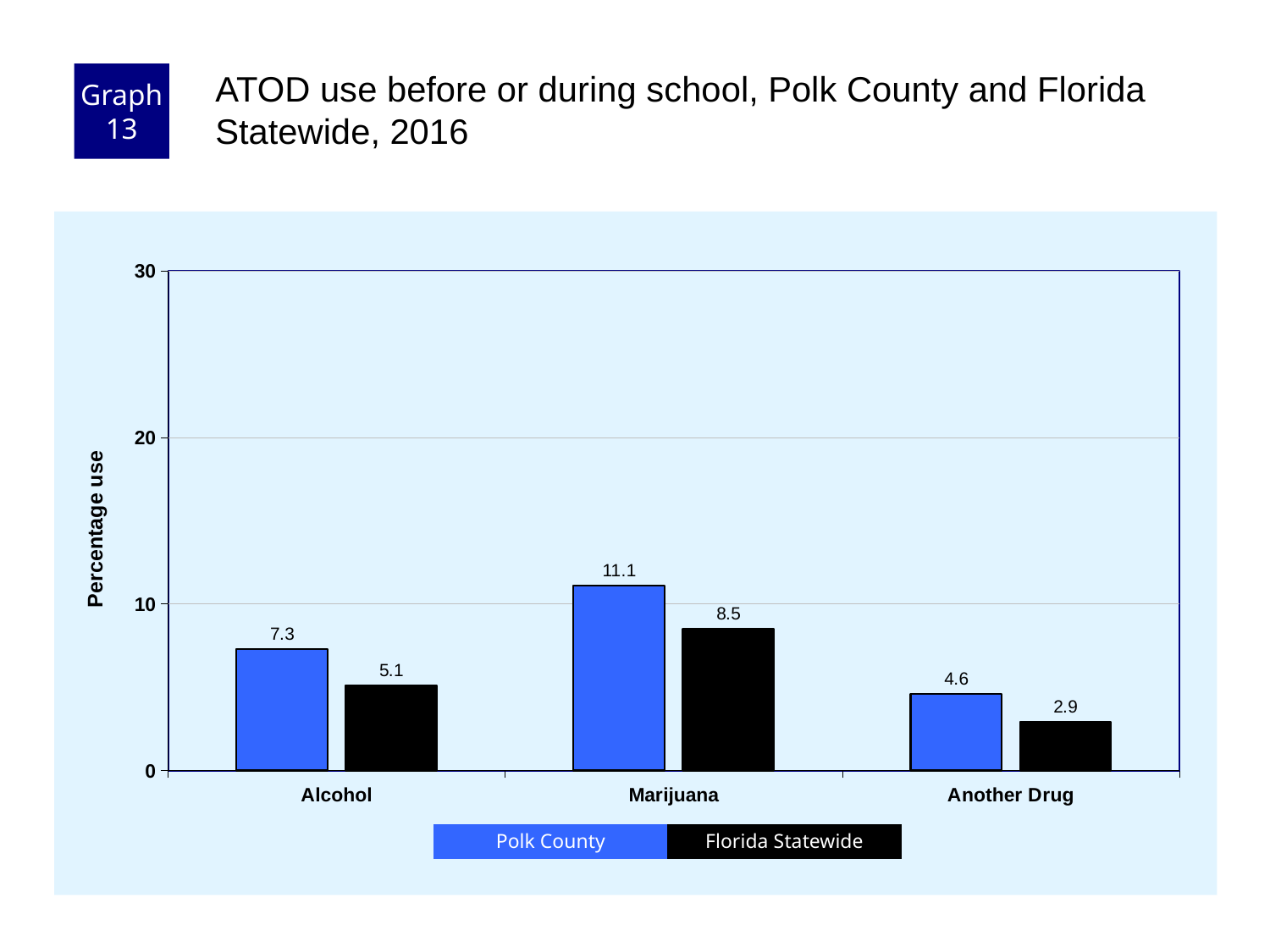
Which category has the highest Polk County value? Marijuana What is the Polk County value for Alcohol? 7.3 How many series does the legend list? 2 Which is larger for Alcohol: the Polk County value or the Florida Statewide value? Polk County What is the label of the y axis? Percentage use What is the difference between the Polk County and Florida Statewide values for Marijuana? 2.6 How many categories are shown on the x axis? 3 What is the Florida Statewide value for Marijuana? 8.5 Is the Polk County value for Marijuana greater or less than 10? greater What kind of chart is shown on the slide? Bar chart Which category has the lowest Florida Statewide value? Another Drug What is the Florida Statewide value for Another Drug? 2.9